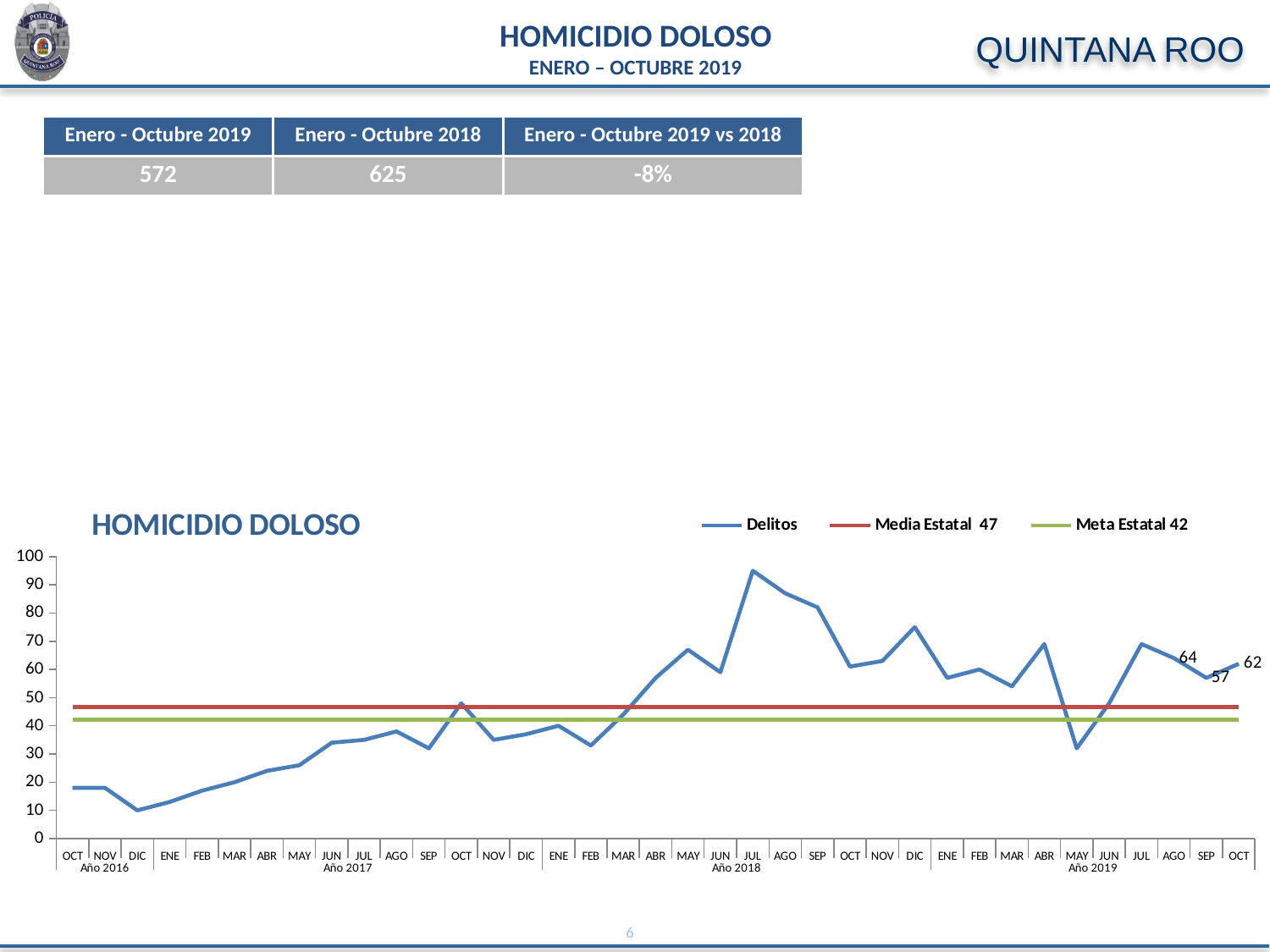
In the HOMICIDIO DOLOSO chart, which month has the highest Delitos value? JUL 2018 In the HOMICIDIO DOLOSO chart, is the Delitos value for DIC of Año 2016 greater or less than 20? less In the HOMICIDIO DOLOSO chart, is the Delitos value for JUL of Año 2018 greater or less than 90? greater In the HOMICIDIO DOLOSO chart, what value does the legend give for Media Estatal? 47 In the HOMICIDIO DOLOSO chart, what is the difference between the Delitos values for AGO 2019 and SEP 2019? 7 In the HOMICIDIO DOLOSO chart, what is the Delitos value for OCT of Año 2019? 62 In the HOMICIDIO DOLOSO chart, which month has the lowest Delitos value? DIC 2016 How many series does the legend of the HOMICIDIO DOLOSO chart list? 3 What type of chart is the HOMICIDIO DOLOSO chart? line chart In the HOMICIDIO DOLOSO chart, which has the larger Delitos value, AGO 2019 or OCT 2019? AGO 2019 In the HOMICIDIO DOLOSO chart, what is the Delitos value for SEP of Año 2019? 57 In the HOMICIDIO DOLOSO chart, what is the Delitos value for AGO of Año 2019? 64